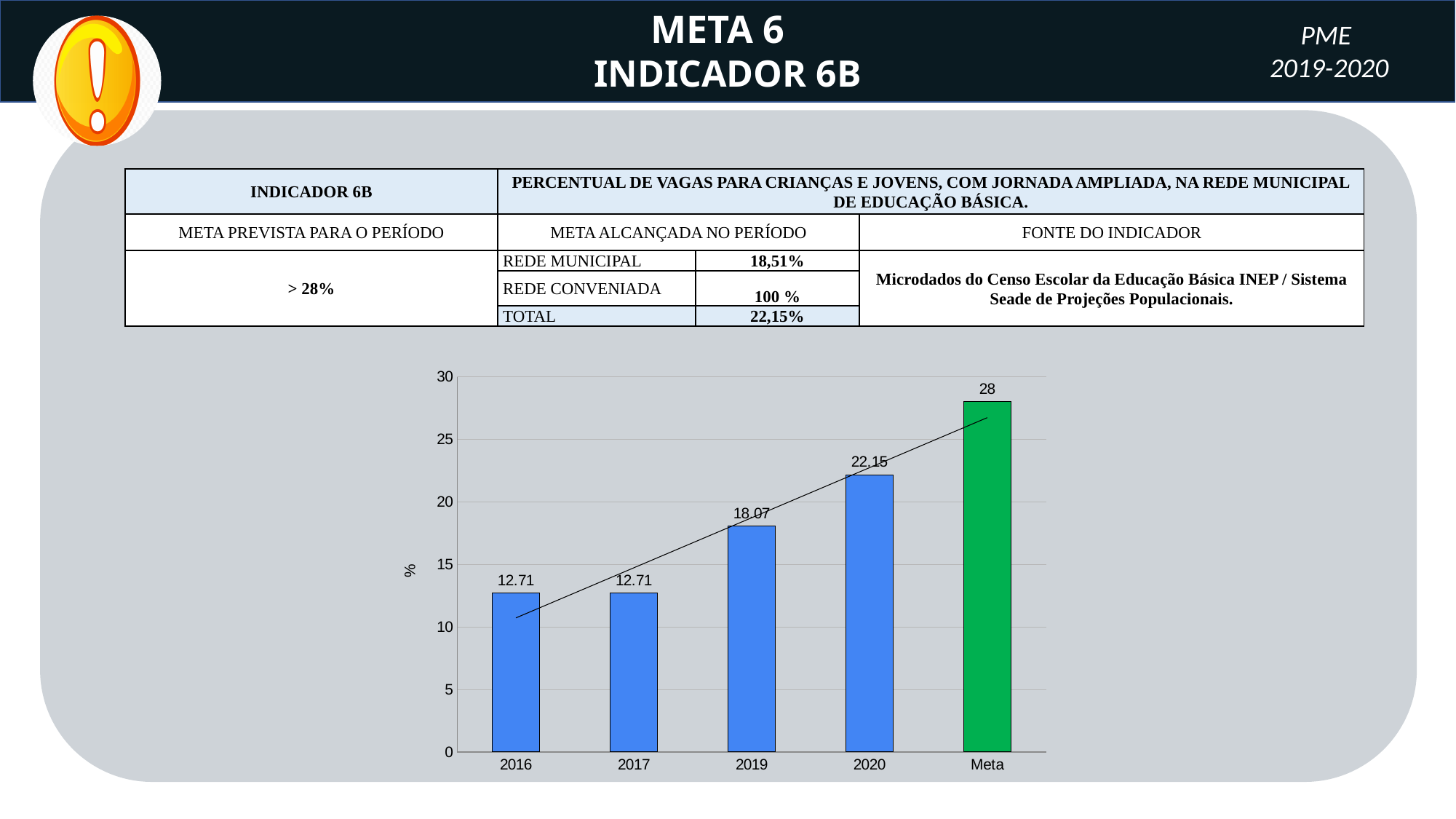
Which year has the lowest value among the years shown (excluding Meta)? 2016 and 2017 (both 12.71) Which is larger, the value for 2019 or the value for 2020? 2020 How many bars are shown in the chart? 5 What is the value for 2016 in the bar chart? 12.71 What is the difference between the Meta value and the 2020 value? 5.85 What type of chart is shown on the slide? Bar chart What is the value for 2020 in the bar chart? 22.15 What is the value of the Meta bar? 28 Do the values rise or fall from 2016 to 2020? Rise What is the difference between the 2019 and 2017 values? 5.36 What is the value for 2019 in the bar chart? 18.07 Which category has the highest bar? Meta